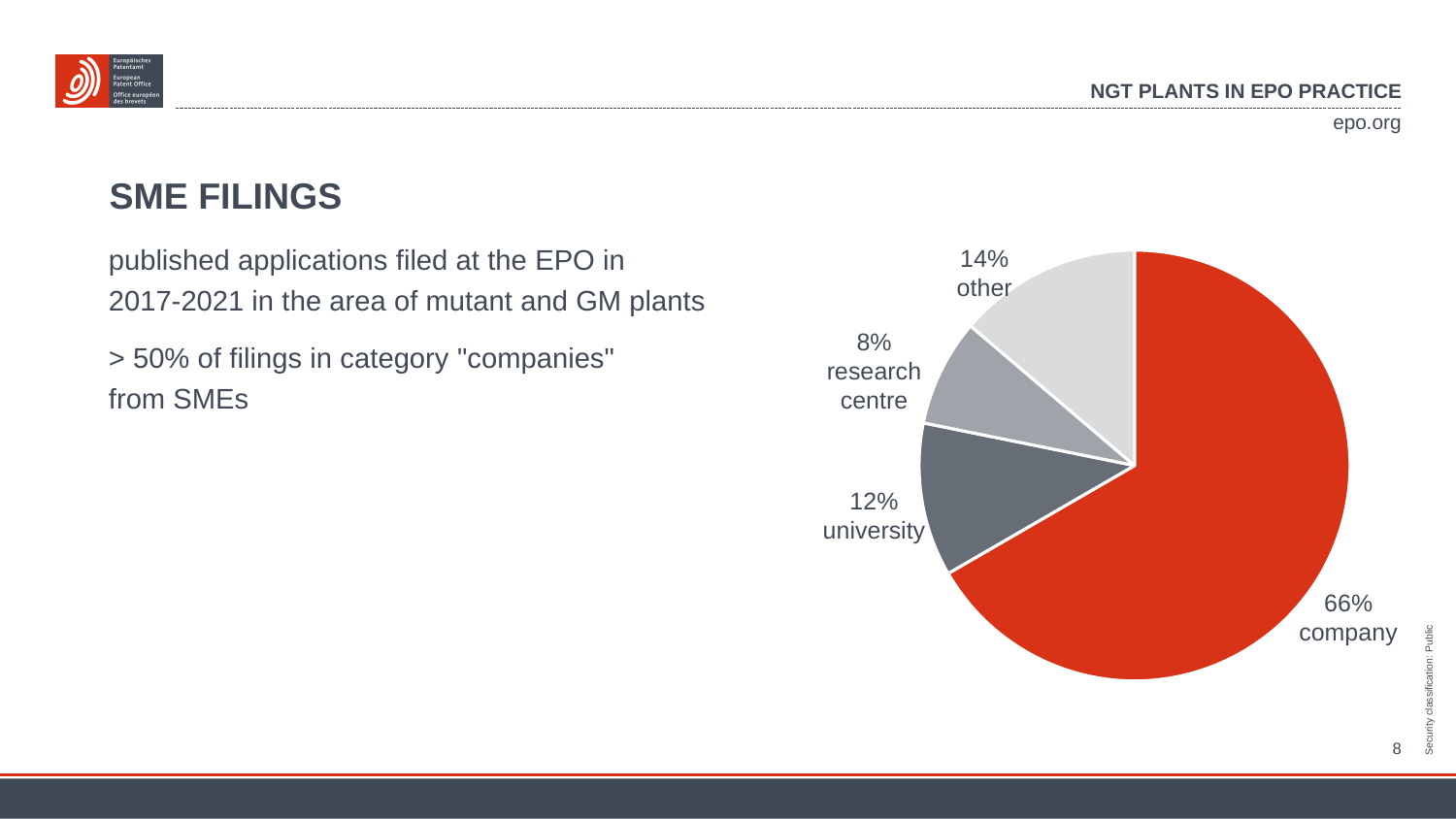
What is the difference between the company share and the university share? 54% What is the value for other? 14% What is the difference between the other share and the research centre share? 6% What colour is the company slice? red What is the value for university? 12% What share of the pie does the company slice represent? 66% Which category has the largest share of the pie? company Which category has the smallest share of the pie? research centre How many slices does the pie chart have? 4 What kind of chart is shown on the slide? pie chart What is the value for research centre? 8% Which is larger, the share for other or the share for university? other